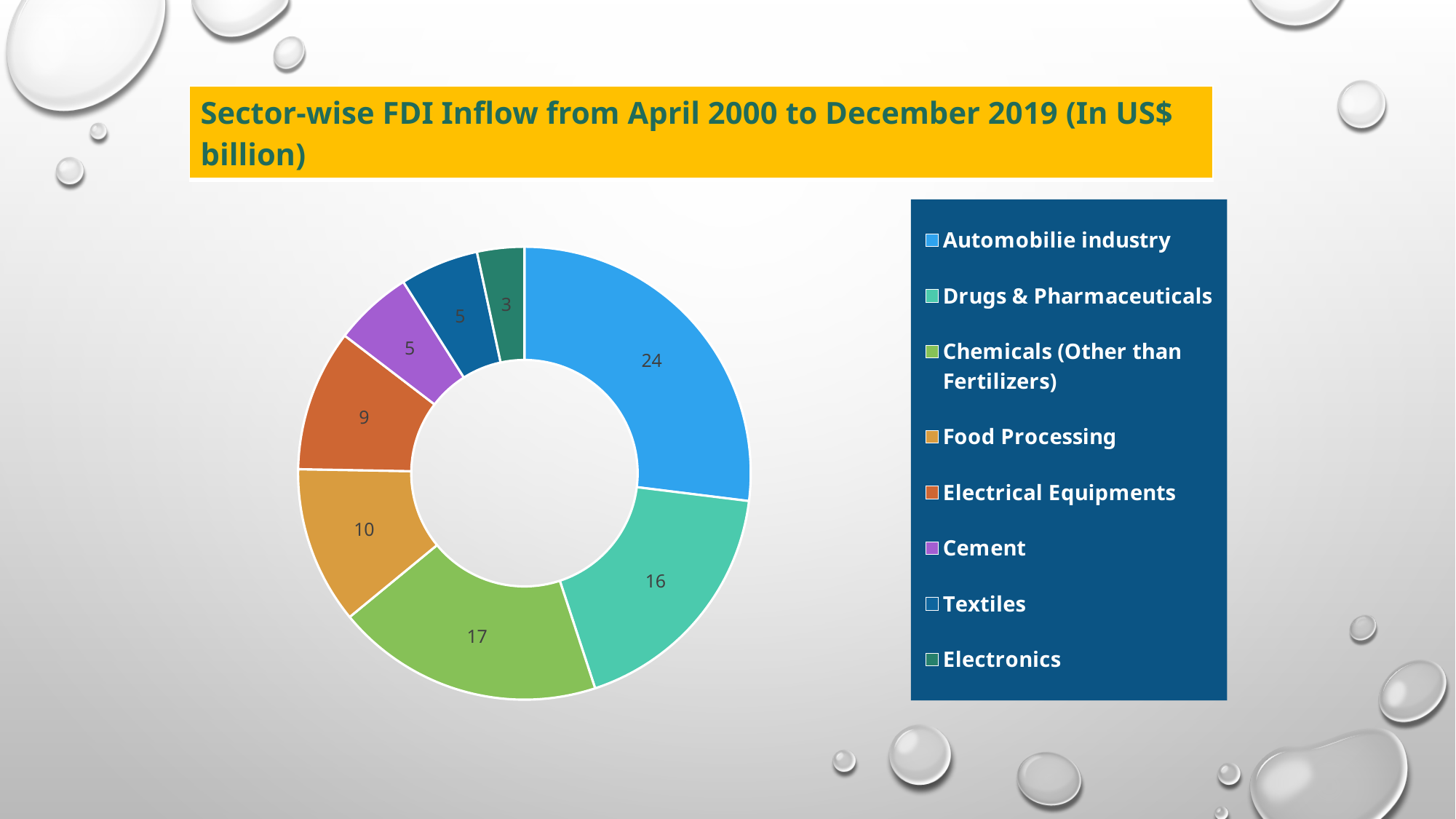
What is the value shown for Food Processing? 10 Which sector has the lowest FDI inflow? Electronics Which is larger, the value for Chemicals (Other than Fertilizers) or the value for Drugs & Pharmaceuticals? Chemicals (Other than Fertilizers) What is the value shown for Electronics? 3 What is the FDI inflow value for the Automobilie industry? 24 What kind of chart is shown on the slide? doughnut chart Which sector has the highest FDI inflow? Automobilie industry How many sectors are shown in the chart? 8 What is the value shown for Chemicals (Other than Fertilizers)? 17 What is the title of the chart? Sector-wise FDI Inflow from April 2000 to December 2019 (In US$ billion) What is the difference between the values for the Automobilie industry and Drugs & Pharmaceuticals? 8 What is the value shown for Drugs & Pharmaceuticals? 16